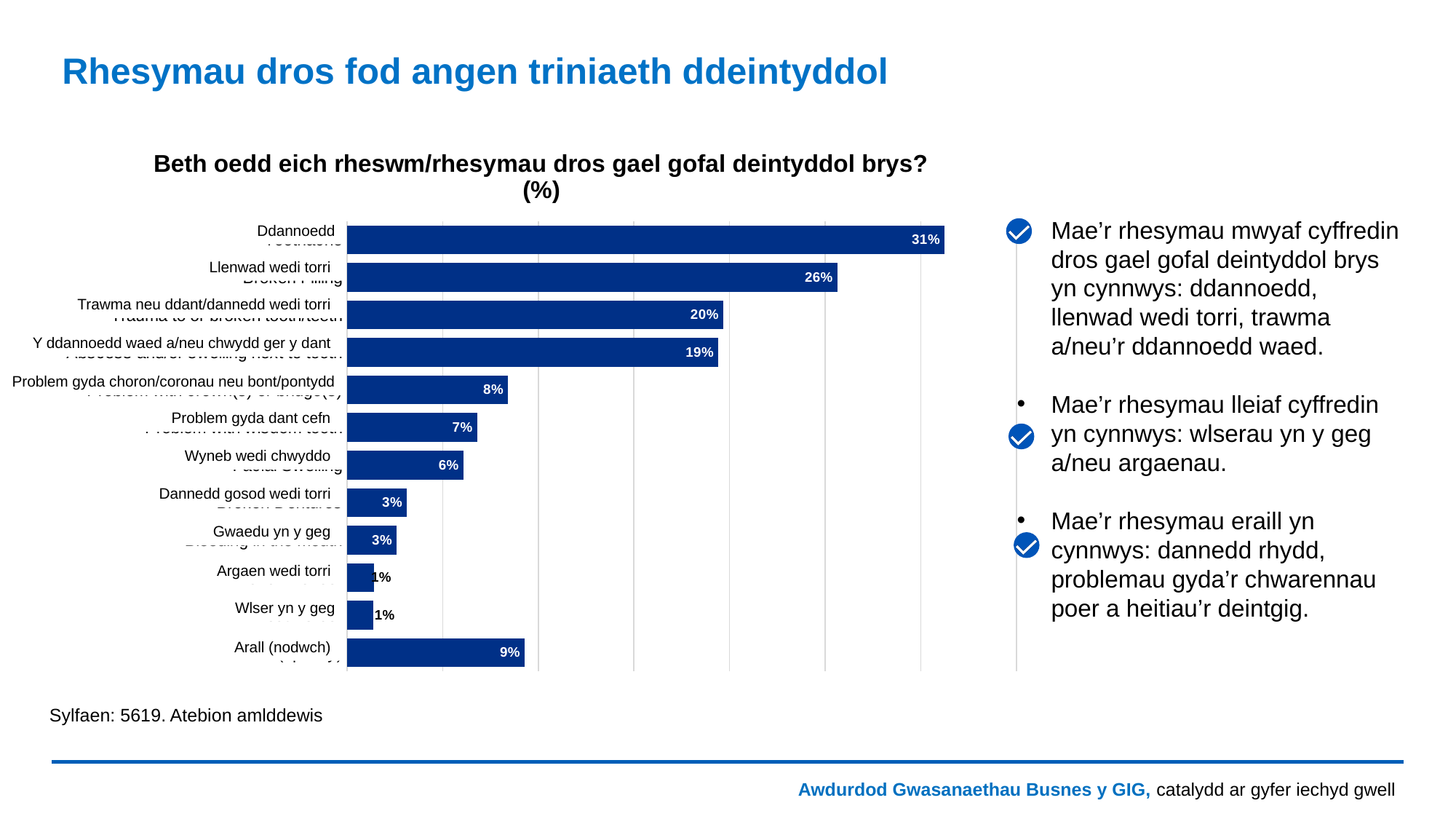
What percentage is shown for Y ddannoedd waed a/neu chwydd ger y dant? 19% How many reason categories are shown in the chart? 12 What is the difference between Trawma neu ddant/dannedd wedi torri and Wyneb wedi chwyddo? 14 What is the base (Sylfaen) number of respondents stated below the chart? 5619 What percentage of respondents gave Ddannoedd as a reason for needing urgent dental care? 31% What is the difference in percentage points between Ddannoedd and Llenwad wedi torri? 5 Which has a larger value: Problem gyda choron/coronau neu bont/pontydd or Wyneb wedi chwyddo? Problem gyda choron/coronau neu bont/pontydd What is the value shown for Llenwad wedi torri? 26% Which has a larger value: Problem gyda dant cefn or Arall (nodwch)? Arall (nodwch) What type of chart is used on the slide? Bar chart What is the value for Arall (nodwch)? 9% Which reason has the highest percentage in the chart? Ddannoedd